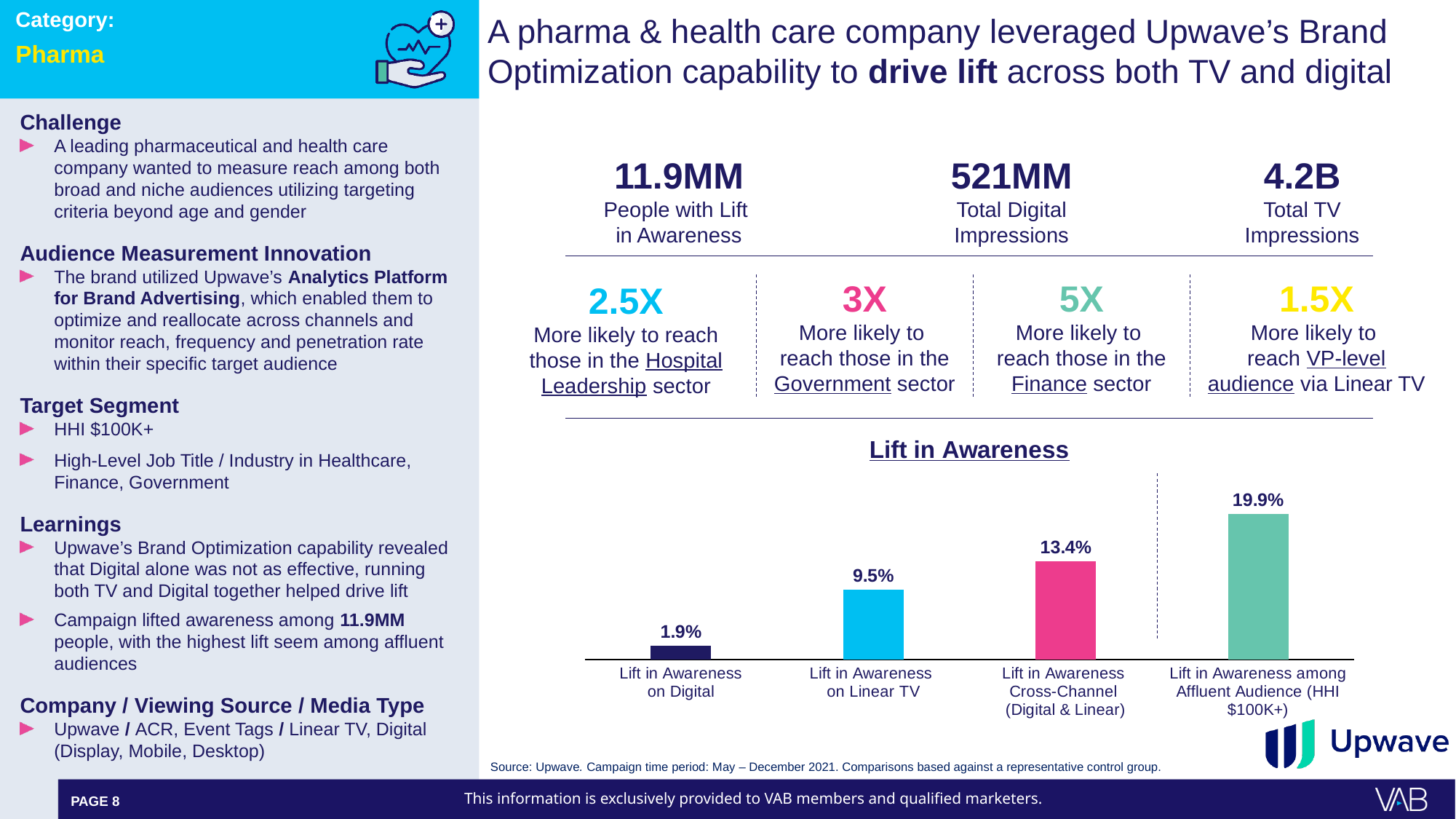
Which is larger: the lift in awareness on Linear TV or Cross-Channel (Digital & Linear)? Cross-Channel (Digital & Linear) How many bars are shown in the Lift in Awareness chart? 4 Which category has the lowest lift in awareness? Lift in Awareness on Digital What is the lift in awareness on Linear TV? 9.5% What type of chart is used to show Lift in Awareness? Bar chart What is the lift in awareness on Digital? 1.9% Which category has the highest lift in awareness? Lift in Awareness among Affluent Audience (HHI $100K+) What is the title of the chart? Lift in Awareness What is the difference between the lift in awareness on Linear TV and on Digital? 7.6% What is the difference between the lift in awareness among the Affluent Audience and Cross-Channel? 6.5% What is the lift in awareness among the Affluent Audience (HHI $100K+)? 19.9% What is the lift in awareness Cross-Channel (Digital & Linear)? 13.4%